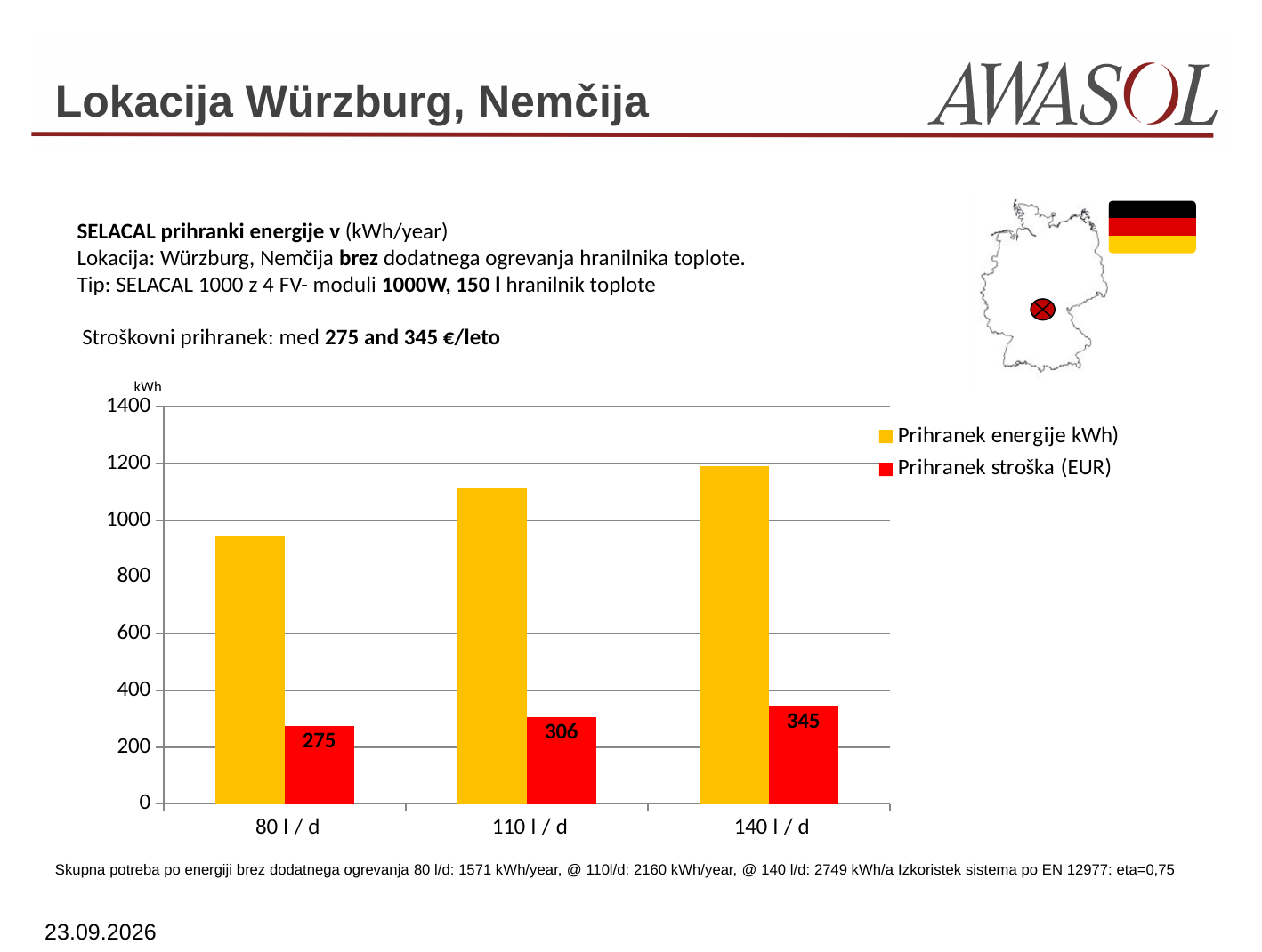
How many series does the legend list? 2 What is the value of Prihranek stroška (EUR) for 110 l / d? 306 What is the difference in Prihranek stroška (EUR) between 140 l / d and 80 l / d? 70 Is the Prihranek energije kWh) value for 80 l / d greater or less than 1000? less What kind of chart is shown on the slide? bar chart Which category has the highest Prihranek stroška (EUR)? 140 l / d What is the value of Prihranek stroška (EUR) for 80 l / d? 275 Is the Prihranek energije kWh) value for 110 l / d greater or less than 1000? greater What is the value of Prihranek stroška (EUR) for 140 l / d? 345 How many categories are shown on the x axis? 3 Which category has the lowest Prihranek energije kWh)? 80 l / d Which is larger: Prihranek energije kWh) for 140 l / d or for 110 l / d? 140 l / d